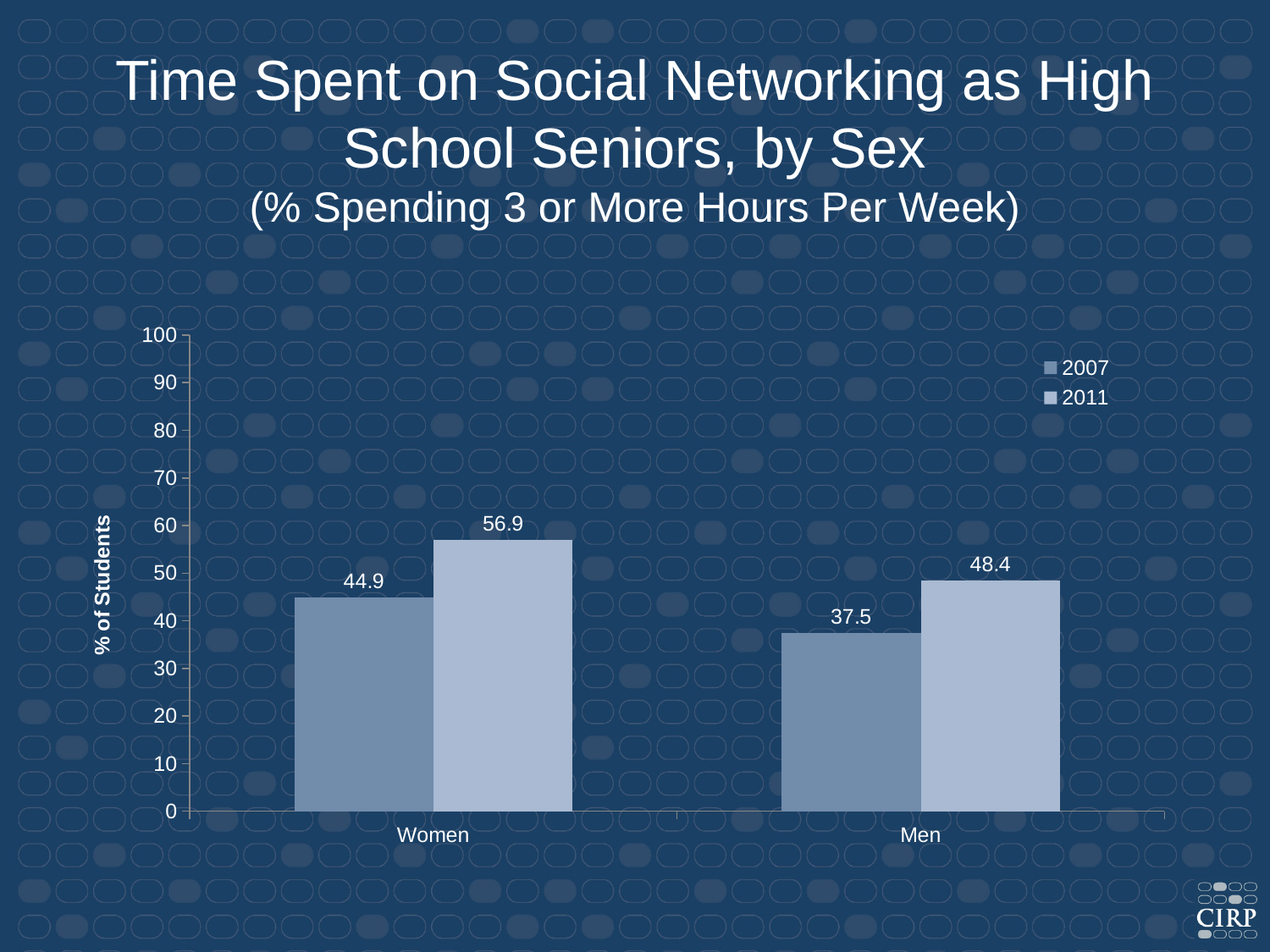
What percentage of women spent 3 or more hours per week on social networking in 2007? 44.9 Which group and year has the lowest value on the chart? Men, 2007 Which is larger: the 2007 value for women or the 2011 value for men? 2011 value for men What percentage of men spent 3 or more hours per week on social networking in 2011? 48.4 What is the label on the vertical axis? % of Students How many series does the legend list? 2 What kind of chart is shown on the slide? Bar chart What is the difference between the 2011 values for women and men? 8.5 What percentage of women spent 3 or more hours per week on social networking in 2011? 56.9 Which group and year has the highest value on the chart? Women, 2011 By how many percentage points did the value for women increase from 2007 to 2011? 12 What percentage of men spent 3 or more hours per week on social networking in 2007? 37.5